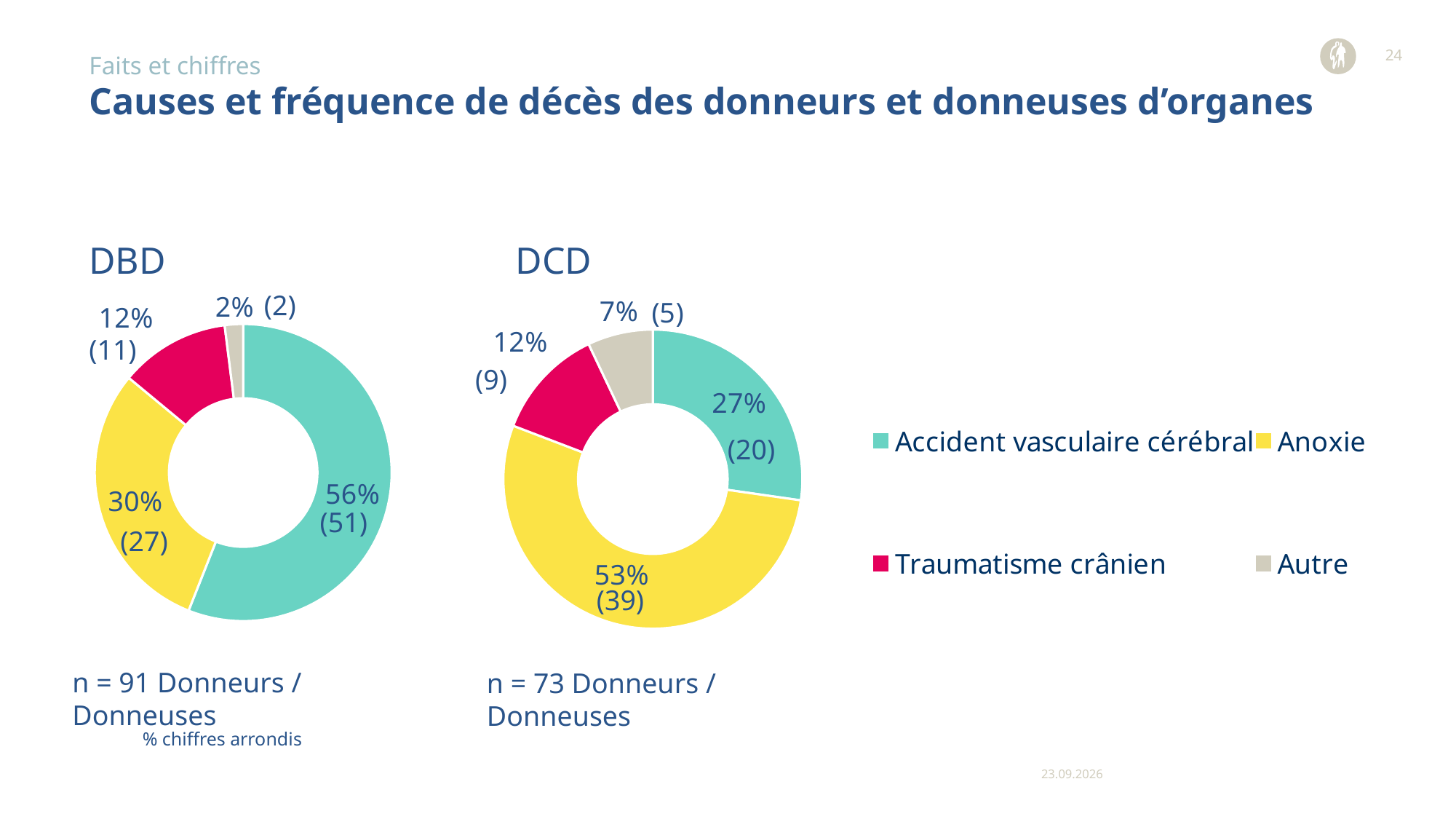
In the DBD chart, how many donors are counted under Anoxie? 27 In the DCD chart, how many donors are counted under Autre? 5 Which colour represents Traumatisme crânien in the legend? Pink/red In the DCD chart, which is larger: the share for Accident vasculaire cérébral or the share for Anoxie? Anoxie In the DCD chart, which cause of death has the smallest share? Autre In the DBD chart, what percentage is shown for Accident vasculaire cérébral? 56% What type of chart is used for DBD and DCD? Donut (pie) chart In the DBD chart, which cause of death has the largest share? Accident vasculaire cérébral In the DCD chart, what percentage is shown for Anoxie? 53% In the DCD chart, what percentage is shown for Traumatisme crânien? 12% In the DBD chart, what is the difference in donor count between Accident vasculaire cérébral and Anoxie? 24 How many categories does each donut chart show? 4